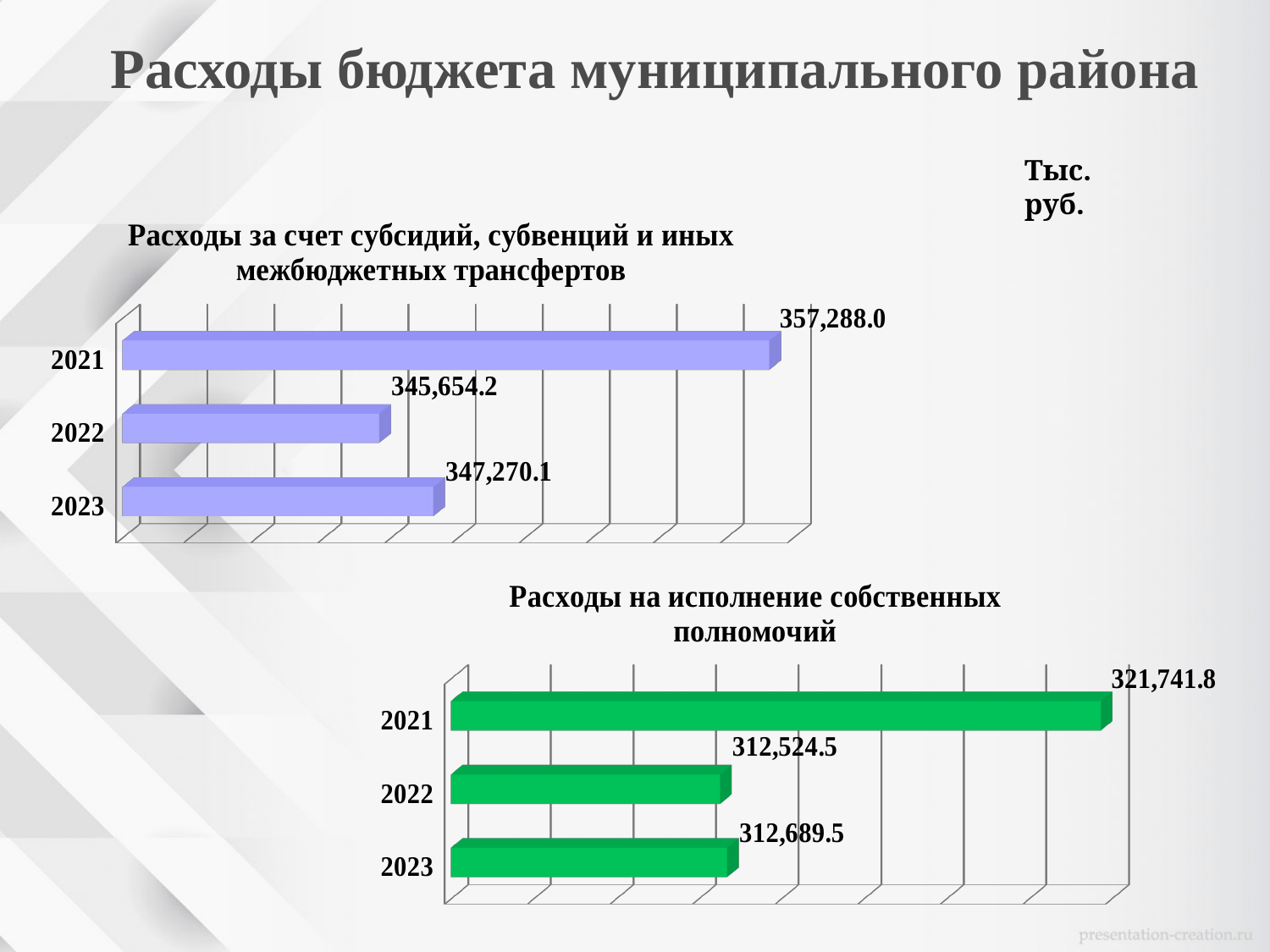
What type of chart is used for 'Расходы за счет субсидий, субвенций и иных межбюджетных трансфертов'? bar chart In the chart 'Расходы на исполнение собственных полномочий', what is the value for 2022? 312,524.5 In the chart 'Расходы на исполнение собственных полномочий', what is the value for 2021? 321,741.8 In the chart 'Расходы за счет субсидий, субвенций и иных межбюджетных трансфертов', which year has the highest value? 2021 In the chart 'Расходы за счет субсидий, субвенций и иных межбюджетных трансфертов', what is the value for 2023? 347,270.1 In the chart 'Расходы на исполнение собственных полномочий', which year has the highest value? 2021 In the chart 'Расходы на исполнение собственных полномочий', what is the value for 2023? 312,689.5 In the chart 'Расходы за счет субсидий, субвенций и иных межбюджетных трансфертов', which year has the lowest value? 2022 In the chart 'Расходы за счет субсидий, субвенций и иных межбюджетных трансфертов', what is the value for 2022? 345,654.2 In the chart 'Расходы за счет субсидий, субвенций и иных межбюджетных трансфертов', what is the value for 2021? 357,288.0 How many years are shown in the chart 'Расходы на исполнение собственных полномочий'? 3 In the chart 'Расходы за счет субсидий, субвенций и иных межбюджетных трансфертов', what is the difference between the 2021 and 2022 values? 11,633.8